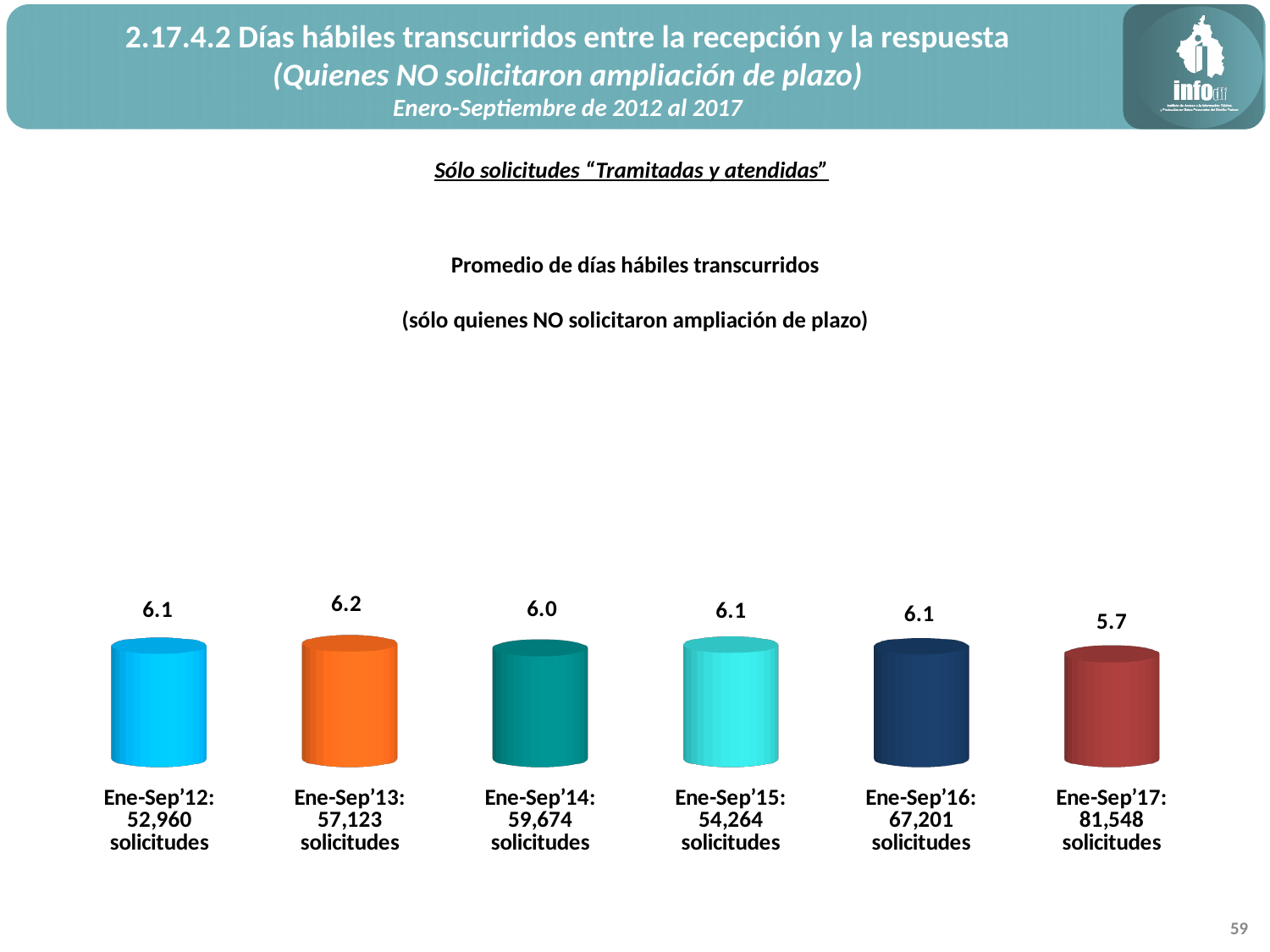
How many solicitudes are listed for Ene-Sep'16? 67,201 What is the difference between the values for Ene-Sep'13 and Ene-Sep'17? 0.5 What kind of chart is shown on the slide? Bar chart What is the average number of business days for Ene-Sep'17? 5.7 What is the average number of business days for Ene-Sep'14? 6.0 What is the title of the chart? Promedio de días hábiles transcurridos (sólo quienes NO solicitaron ampliación de plazo) How many periods are shown in the chart? 6 What is the average number of business days for Ene-Sep'12? 6.1 Which period has the highest average number of business days? Ene-Sep'13 Which is larger, the value for Ene-Sep'13 or the value for Ene-Sep'14? Ene-Sep'13 Which period has the lowest average number of business days? Ene-Sep'17 How many solicitudes are listed for Ene-Sep'17? 81,548